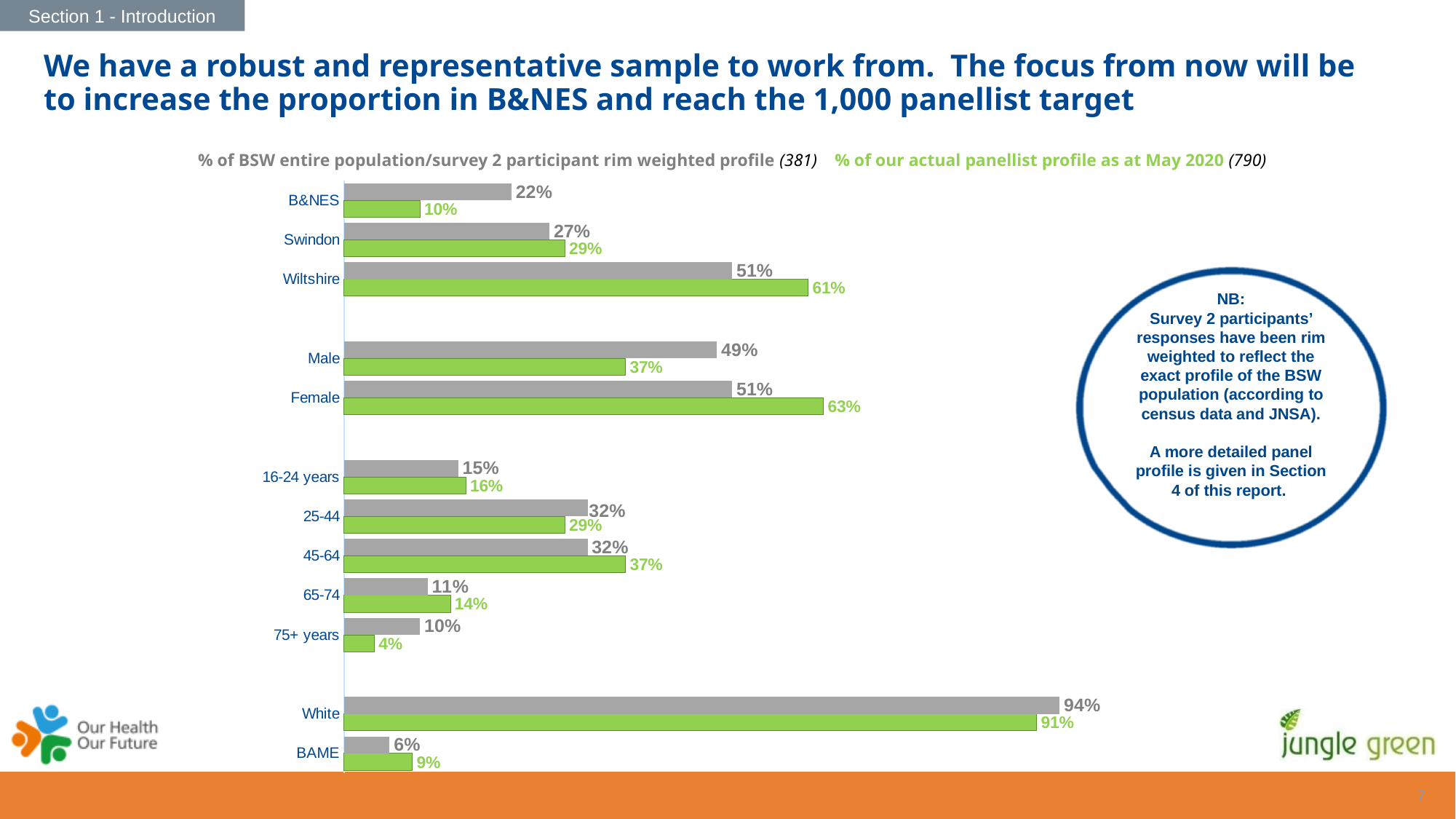
What is the value for B&NES in the '% of our actual panellist profile as at May 2020' series? 10% For Male, which series has the larger value: the rim weighted profile or the actual panellist profile? % of BSW entire population/survey 2 participant rim weighted profile What is the value for 45-64 in the '% of our actual panellist profile as at May 2020' series? 37% Which category has the highest value in the '% of BSW entire population/survey 2 participant rim weighted profile' series? White How many series does the legend list? 2 What is the difference between the two series' values for B&NES? 12% Which category has the lowest value in the '% of our actual panellist profile as at May 2020' series? 75+ years What kind of chart is shown on the slide? Bar chart What is the value for Wiltshire in the '% of BSW entire population/survey 2 participant rim weighted profile' series? 51% What colour are the bars for the '% of our actual panellist profile as at May 2020' series? Green What is the value for Female in the '% of our actual panellist profile as at May 2020' series? 63% How many categories are plotted on the chart? 12